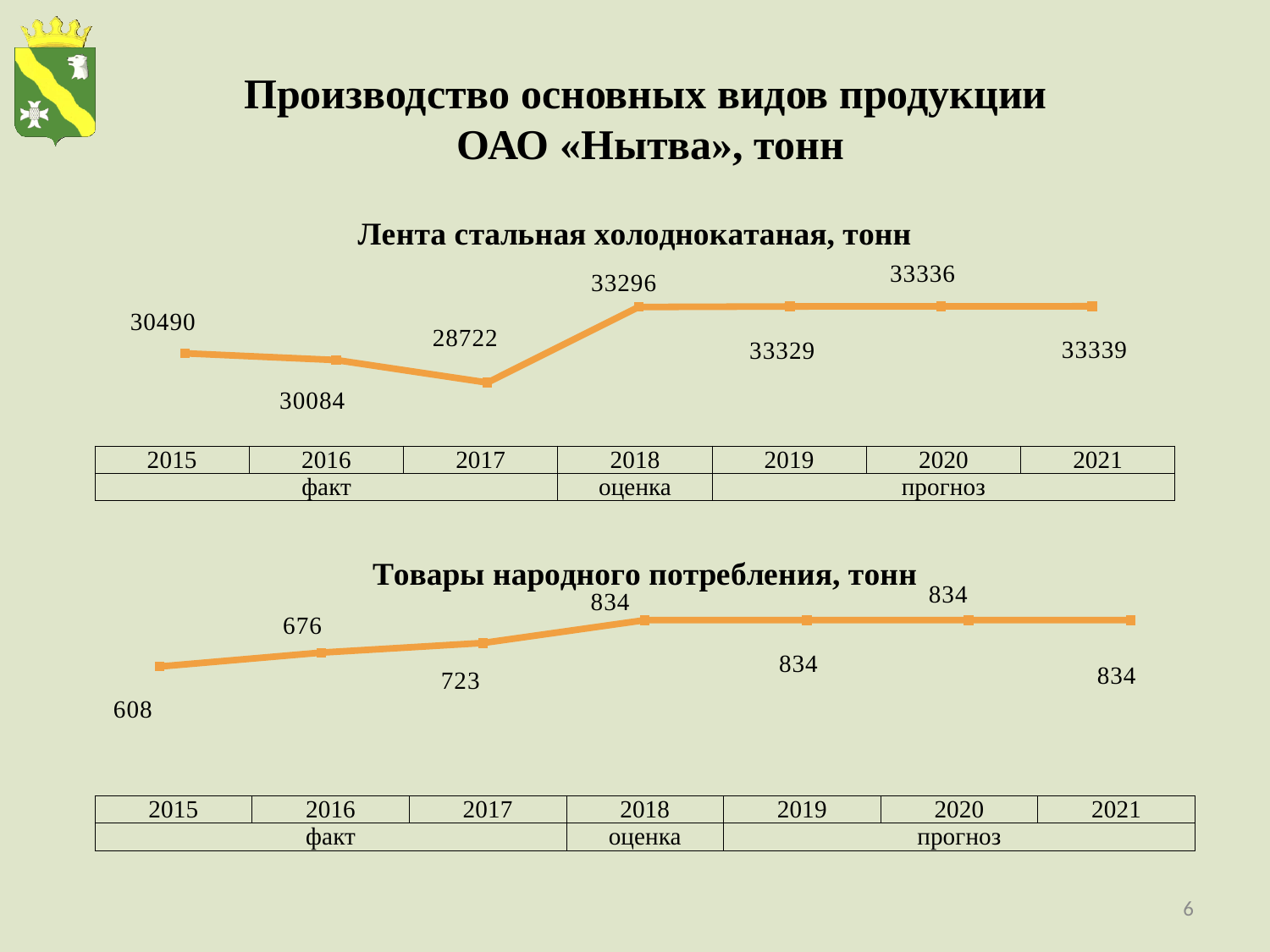
In the chart 'Товары народного потребления, тонн', what is the value for 2015? 608 In the chart 'Лента стальная холоднокатаная, тонн', which is larger, the value for 2015 or the value for 2016? 2015 In the chart 'Лента стальная холоднокатаная, тонн', which year has the lowest value? 2017 What type of chart is 'Товары народного потребления, тонн'? line chart In the chart 'Товары народного потребления, тонн', what is the difference between the values for 2018 and 2015? 226 In the chart 'Лента стальная холоднокатаная, тонн', how many years are plotted? 7 In the chart 'Лента стальная холоднокатаная, тонн', what is the value for 2015? 30490 In the chart 'Товары народного потребления, тонн', do the values rise or fall from 2015 to 2018? rise In the chart 'Лента стальная холоднокатаная, тонн', what is the value for 2017? 28722 In the chart 'Товары народного потребления, тонн', which years are labelled as 'прогноз' in the table below the chart? 2019, 2020, 2021 In the chart 'Лента стальная холоднокатаная, тонн', what is the difference between the values for 2018 and 2017? 4574 In the chart 'Товары народного потребления, тонн', what is the value for 2017? 723